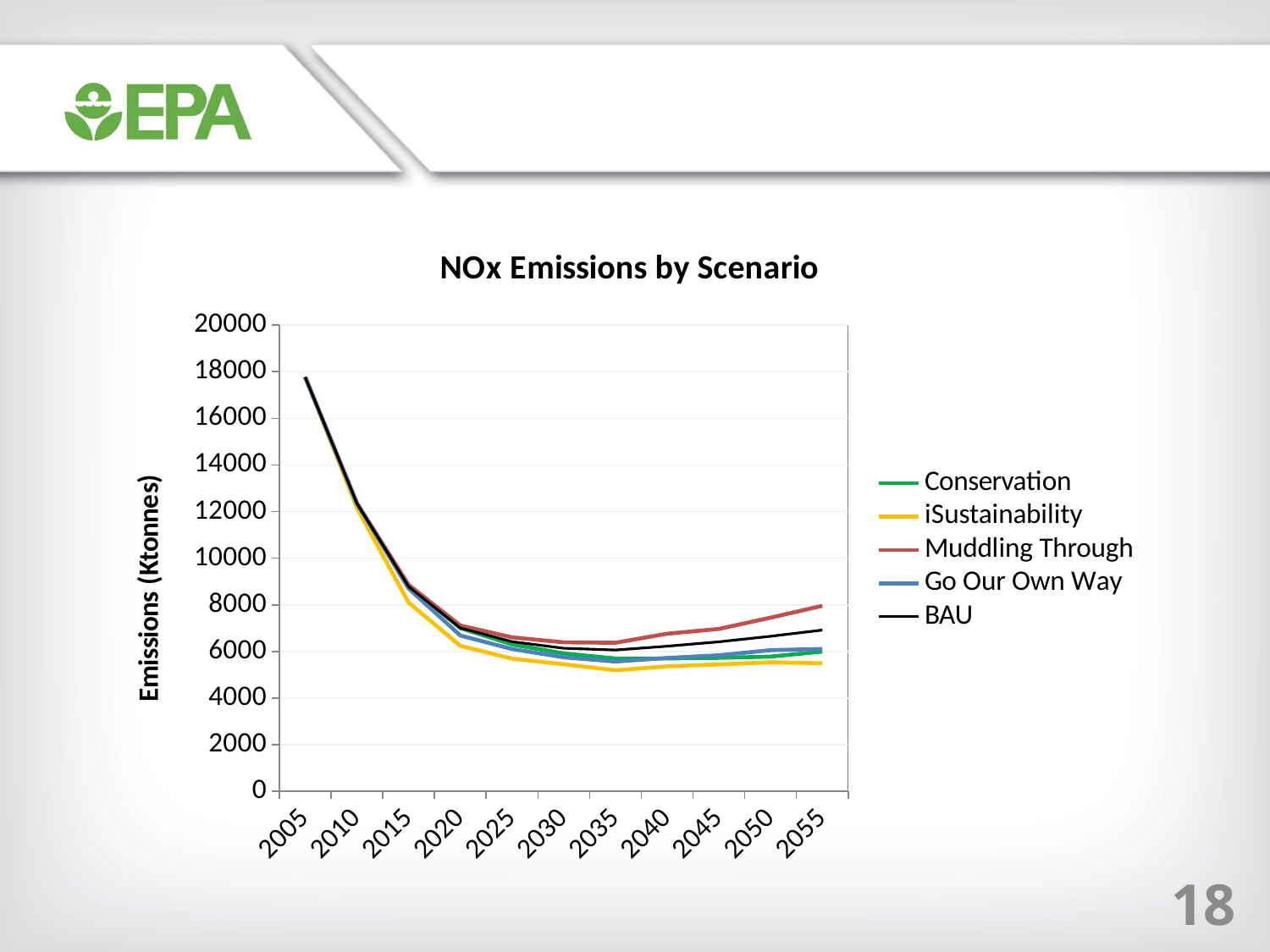
What kind of chart is shown on the slide? line chart Which scenario has the highest emissions in 2055? Muddling Through In 2055, which is larger: Muddling Through or iSustainability? Muddling Through What is the label on the y axis? Emissions (Ktonnes) Is the iSustainability value in 2035 greater or less than 6000? less Which scenario has the lowest emissions in 2055? iSustainability How many years are marked along the x axis? 11 What is the title of the chart? NOx Emissions by Scenario Do emissions rise or fall between 2005 and 2020? fall Is the emissions value in 2005 greater or less than 16000? greater Is the Muddling Through value in 2055 greater or less than 7000? greater How many series does the legend list? 5